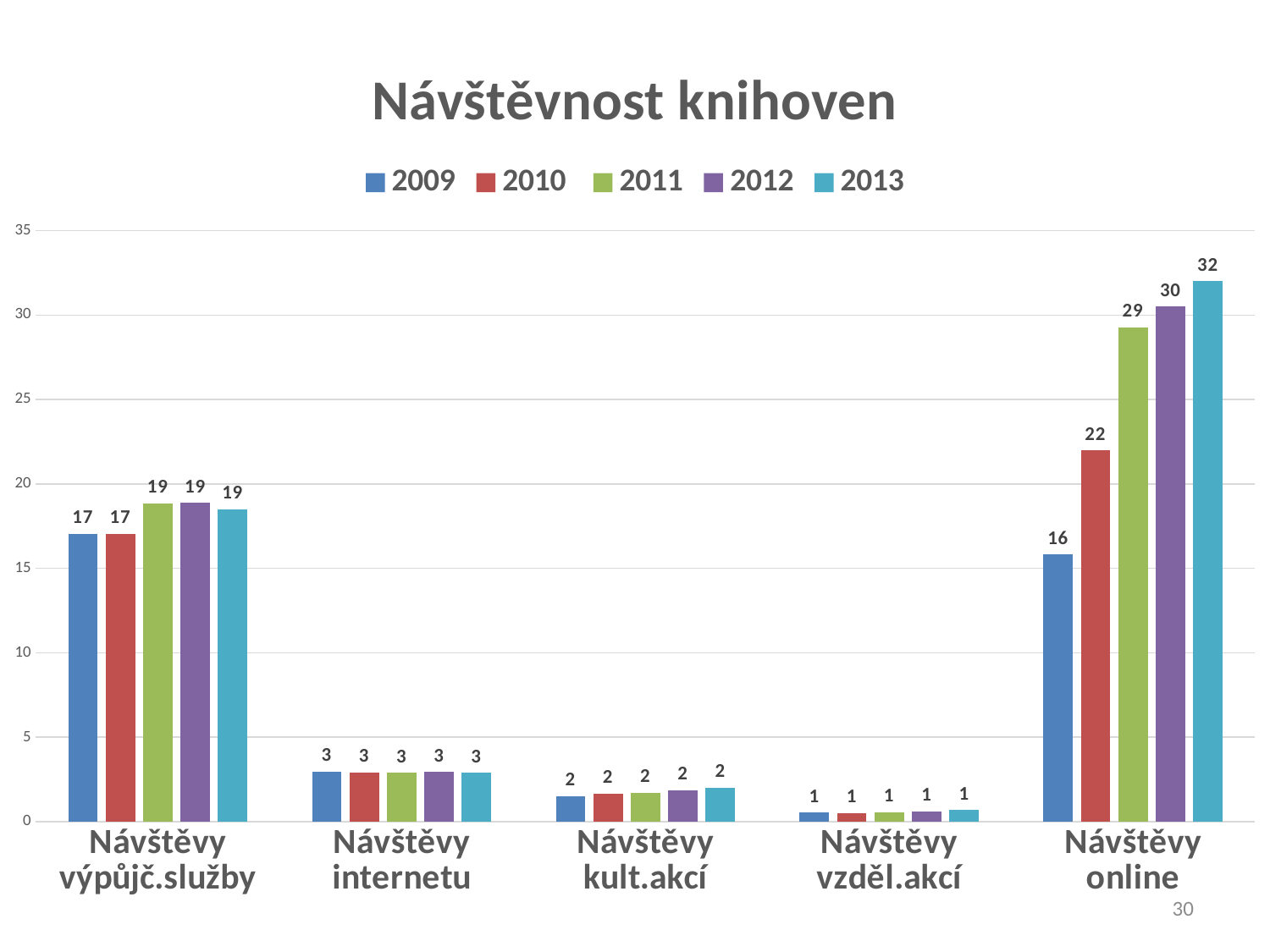
Which year has the highest value in the Návštěvy online category? 2013 How many series does the legend list? 5 What is the value for 2010 in the Návštěvy online category? 22 What is the value for 2013 in the Návštěvy online category? 32 Is the 2012 value for Návštěvy online greater or less than 25? greater Which category has the lowest values across all years? Návštěvy vzděl.akcí Which is larger: the 2011 value for Návštěvy výpůjč.služby or the 2011 value for Návštěvy online? Návštěvy online What is the value for 2009 in the Návštěvy výpůjč.služby category? 17 What is the difference between the 2013 and 2009 values in the Návštěvy online category? 16 What kind of chart is shown on the slide? Bar chart How many categories are shown on the x axis? 5 Do the values in the Návštěvy online category rise or fall from 2009 to 2013? Rise